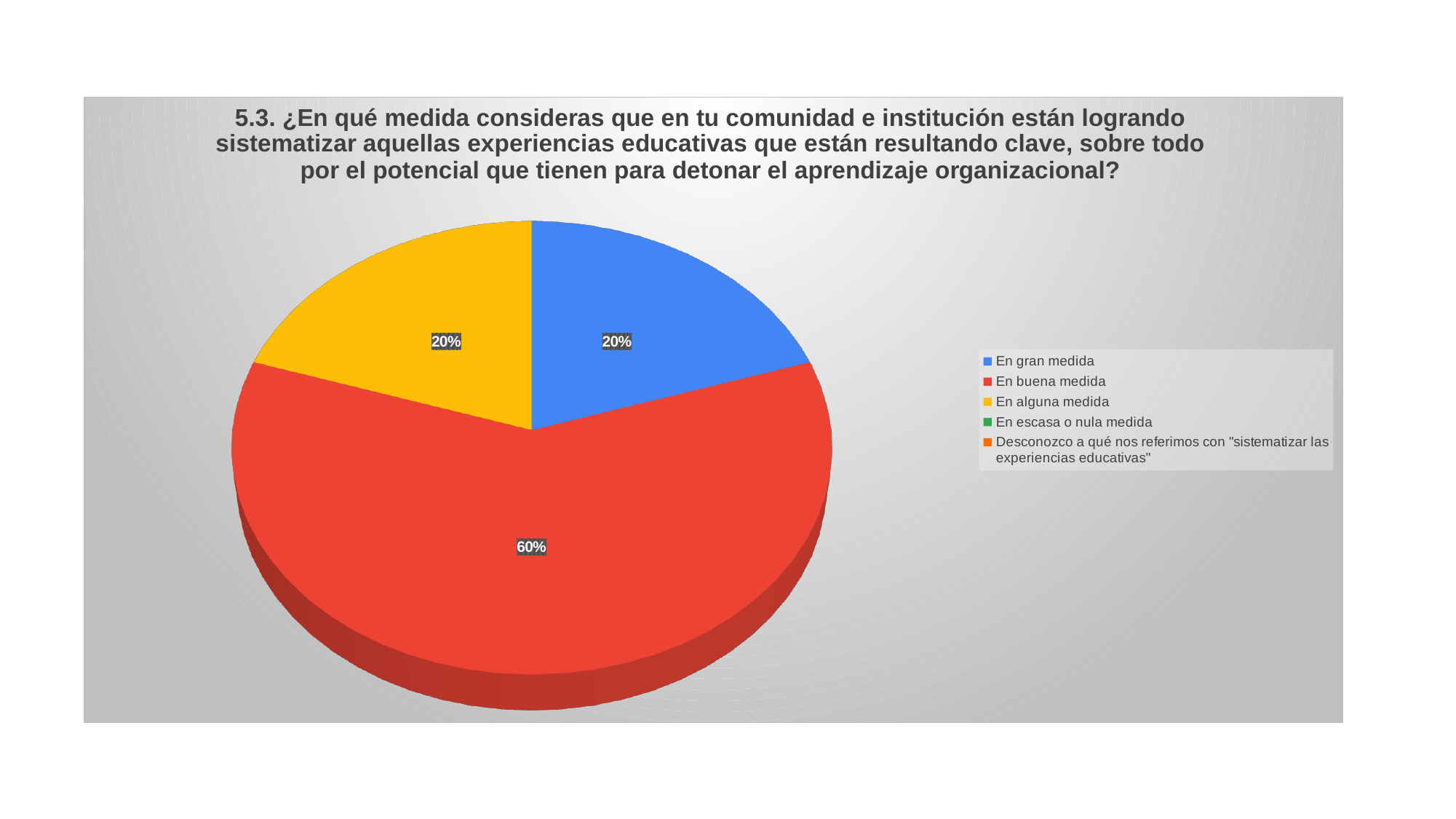
What share of the pie does "En alguna medida" represent? 20% How many entries does the legend list? 5 Is the share for "En buena medida" greater or less than 50%? greater What share of the pie does "En gran medida" represent? 20% What colour is the slice for "En gran medida"? Blue Which category has the largest slice of the pie? En buena medida Which legend entry is shown in yellow? En alguna medida Which is larger, the share for "En buena medida" or the share for "En alguna medida"? En buena medida What kind of chart is shown on the slide? Pie chart How many slices are visible in the pie? 3 What is the difference between the share for "En buena medida" and the share for "En gran medida"? 40% What share of the pie does "En buena medida" represent? 60%